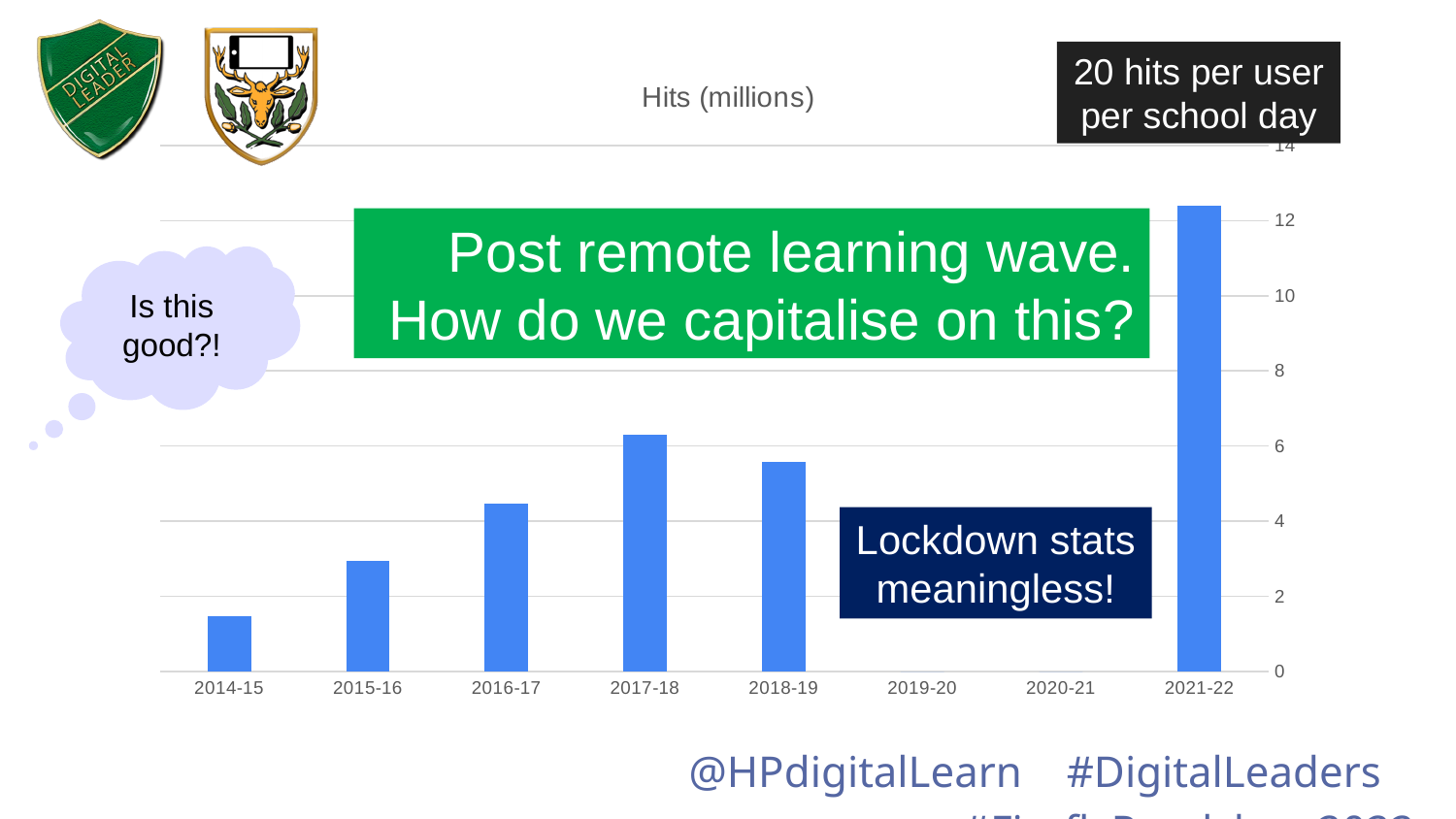
How many school-year categories are shown on the x axis of the chart? 8 Do the values rise or fall from 2014-15 to 2017-18? rise Is the value for 2014-15 greater or less than 2? less Is the value for 2021-22 greater or less than 10? greater What is the title of the chart? Hits (millions) What kind of chart is shown on the slide? bar chart Which is larger, the value for 2015-16 or the value for 2016-17? 2016-17 Which is larger, the value for 2017-18 or the value for 2018-19? 2017-18 Which school year has the lowest visible bar in the chart? 2014-15 Is the value for 2016-17 greater or less than 4? greater Which school year has the highest bar in the chart? 2021-22 What is the highest tick value shown on the y axis of the chart? 14